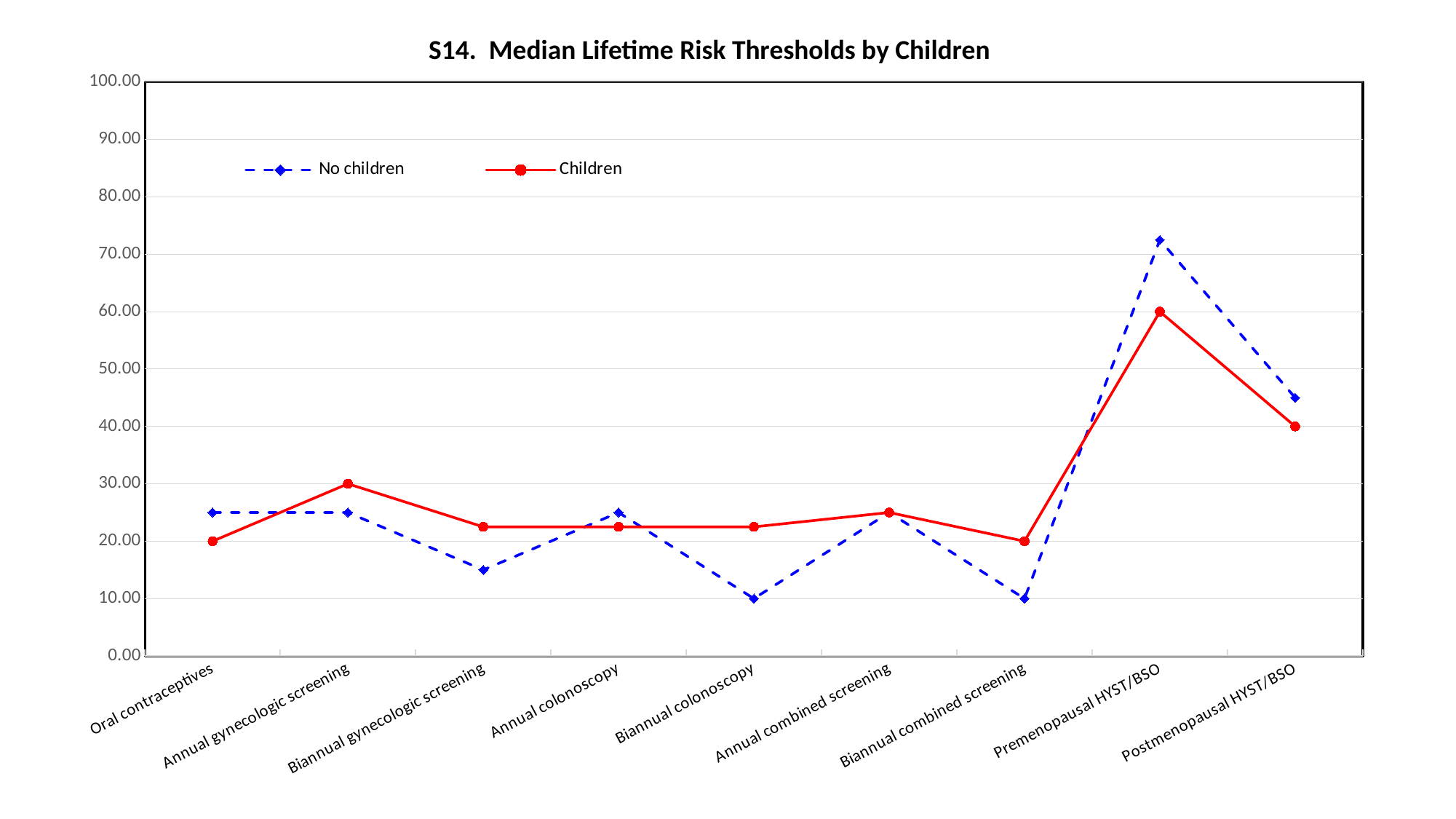
Which series is drawn with a dashed blue line? No children For Premenopausal HYST/BSO, which series has the larger value, No children or Children? No children What is the Children value for Postmenopausal HYST/BSO? 40.00 What is the Children value for Premenopausal HYST/BSO? 60.00 What is the Children value for Annual gynecologic screening? 30.00 How many series does the legend list? 2 What kind of chart is shown on the slide? line chart Is the No children value for Premenopausal HYST/BSO greater or less than 70.00? greater How many categories are plotted along the x axis? 9 For which category is the No children series highest? Premenopausal HYST/BSO What is the No children value for Biannual colonoscopy? 10.00 For Biannual colonoscopy, which series has the larger value, No children or Children? Children